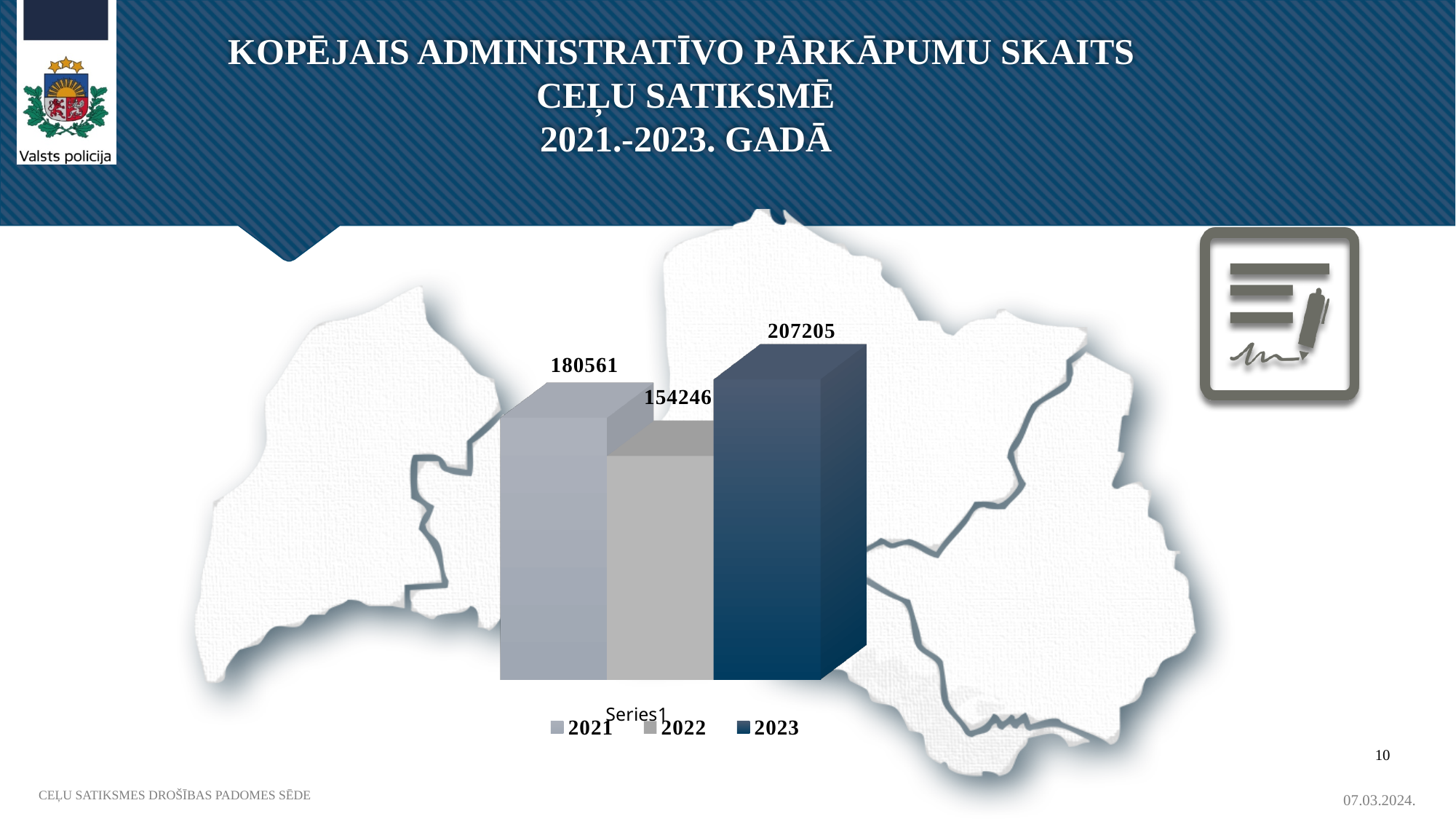
What is the difference between the values for 2021 and 2022? 26315 What is the value shown for 2021? 180561 Which year has the lowest value? 2022 Does the value rise or fall from 2022 to 2023? Rises How many bars are plotted in the chart? 3 Which is larger, the value for 2021 or the value for 2022? 2021 What is the difference between the values for 2023 and 2021? 26644 What kind of chart is shown on the slide? Bar chart How many entries does the legend list? 3 What is the value shown for 2022? 154246 Which year has the highest value? 2023 What is the value shown for 2023? 207205